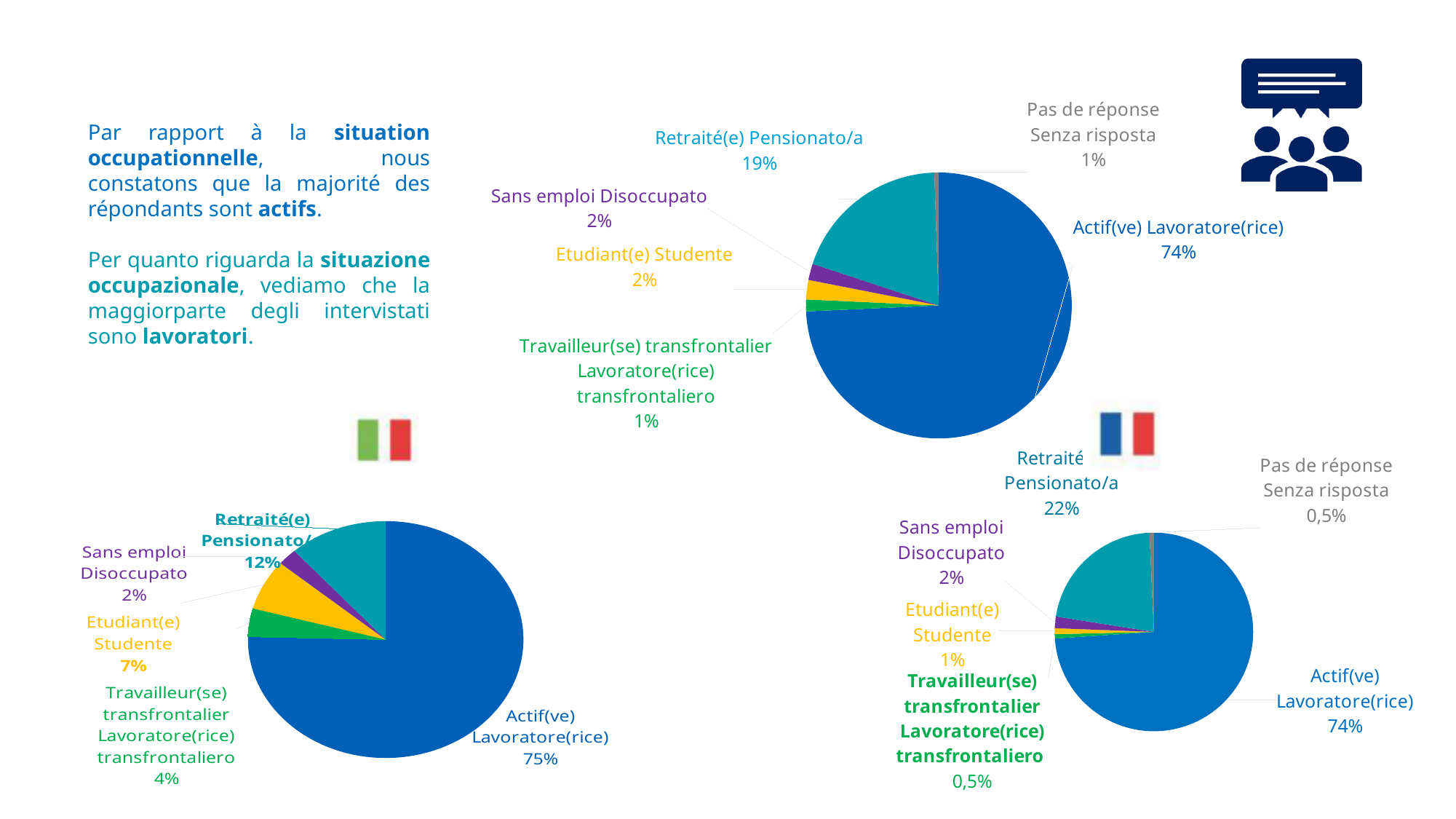
In the bottom-left pie chart (Italian flag), what percentage is shown for Actif(ve) Lavoratore(rice)? 75% In the bottom-left pie chart (Italian flag), what share is Travailleur(se) transfrontalier Lavoratore(rice) transfrontaliero? 4% In the bottom-left pie chart (Italian flag), what percentage is shown for Etudiant(e) Studente? 7% In the top pie chart, which category has the largest slice? Actif(ve) Lavoratore(rice) In the bottom-right pie chart (French flag), which is larger: Sans emploi Disoccupato or Etudiant(e) Studente? Sans emploi Disoccupato In the top pie chart, what percentage is shown for Retraité(e) Pensionato/a? 19% In the bottom-right pie chart (French flag), what percentage is shown for Retraité Pensionato/a? 22% In the bottom-right pie chart (French flag), what share is Pas de réponse Senza risposta? 0,5% In the top pie chart, what share of respondents are Actif(ve) Lavoratore(rice)? 74% What type of chart is used on this slide? Pie chart How many categories are labelled in the bottom-right pie chart (French flag)? 6 In the top pie chart, what is the difference between the Actif(ve) Lavoratore(rice) share and the Retraité(e) Pensionato/a share? 55%